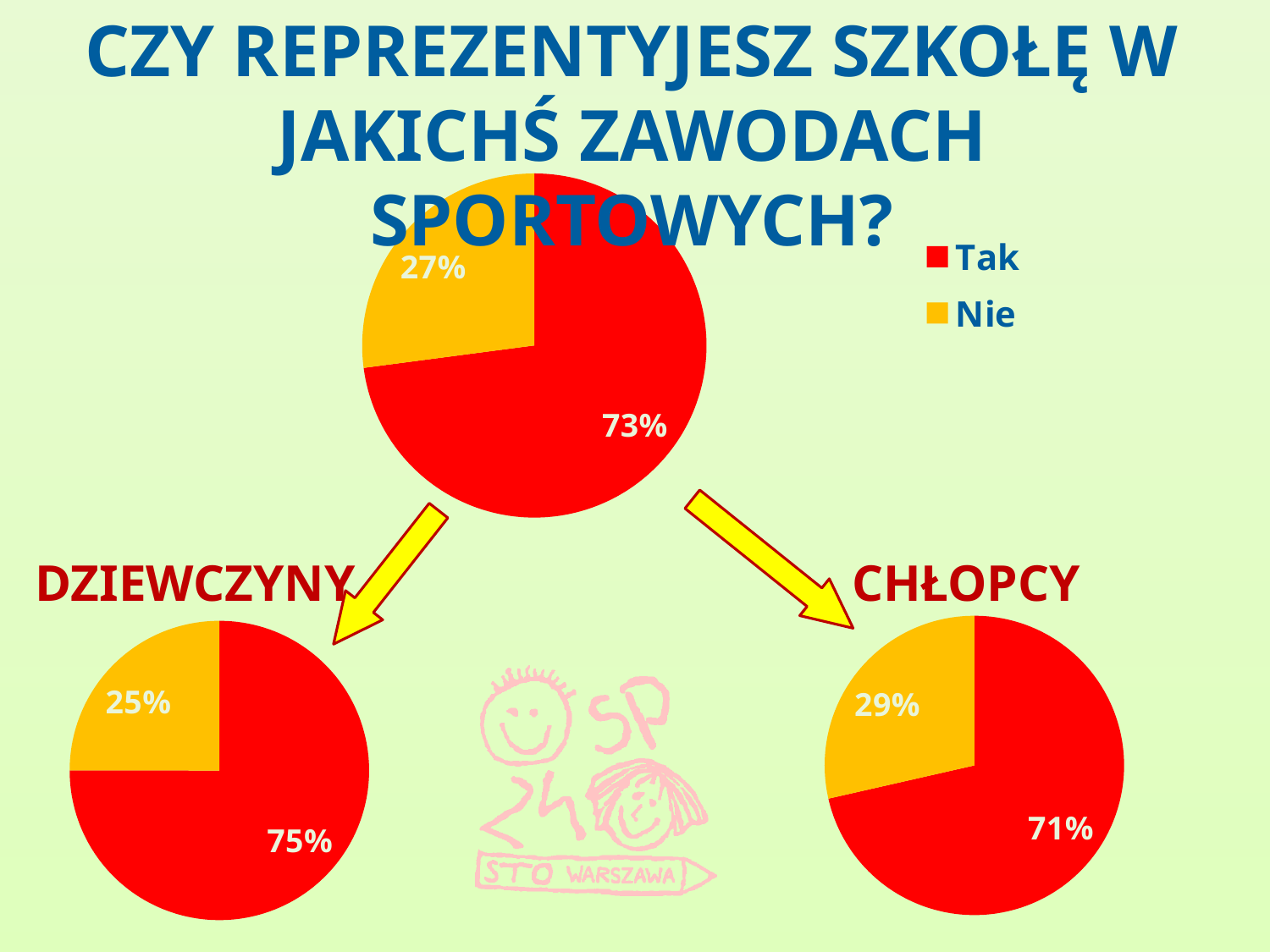
In the CHŁOPCY pie chart, what percentage answered Nie? 29% Comparing the DZIEWCZYNY and CHŁOPCY pie charts, which group has the larger Tak share? DZIEWCZYNY In the DZIEWCZYNY pie chart, what is the difference between the Tak and Nie shares? 50% In the top pie chart, which answer has the largest share? Tak In the CHŁOPCY pie chart, which answer has the smallest share? Nie How many entries does the legend list? 2 In the DZIEWCZYNY pie chart, what percentage answered Tak? 75% In the DZIEWCZYNY pie chart, what percentage answered Nie? 25% In the CHŁOPCY pie chart, what percentage answered Tak? 71% In the top pie chart, what percentage answered Tak? 73% In the top pie chart, what percentage answered Nie? 27% What type of chart is used on this slide? Pie chart